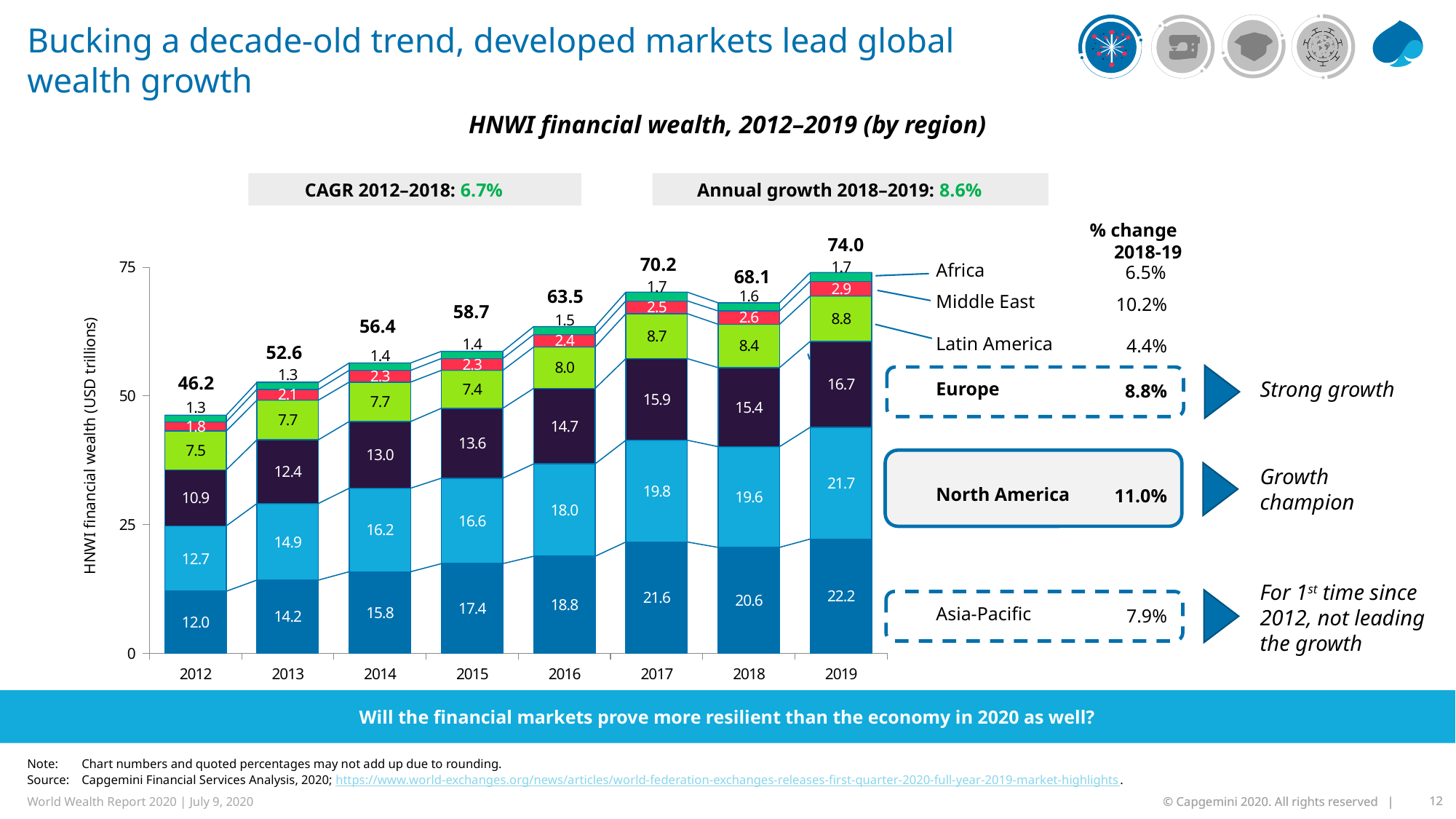
What kind of chart is used to show HNWI financial wealth by region? Stacked bar chart What is the Europe value for 2012? 10.9 How many years are shown on the x axis? 8 Did the total HNWI financial wealth rise or fall from 2017 to 2018? Fall Which is larger in 2019, the North America value or the Asia-Pacific value? Asia-Pacific What is the difference between the total for 2018 and the total for 2017? 2.1 What is the total HNWI financial wealth shown for 2019? 74.0 What is the CAGR for 2012–2018 shown above the chart? 6.7% Which year has the lowest total HNWI financial wealth? 2012 Which year has the highest total HNWI financial wealth? 2019 What is the Middle East value for 2019? 2.9 What is the Asia-Pacific value for 2017? 21.6